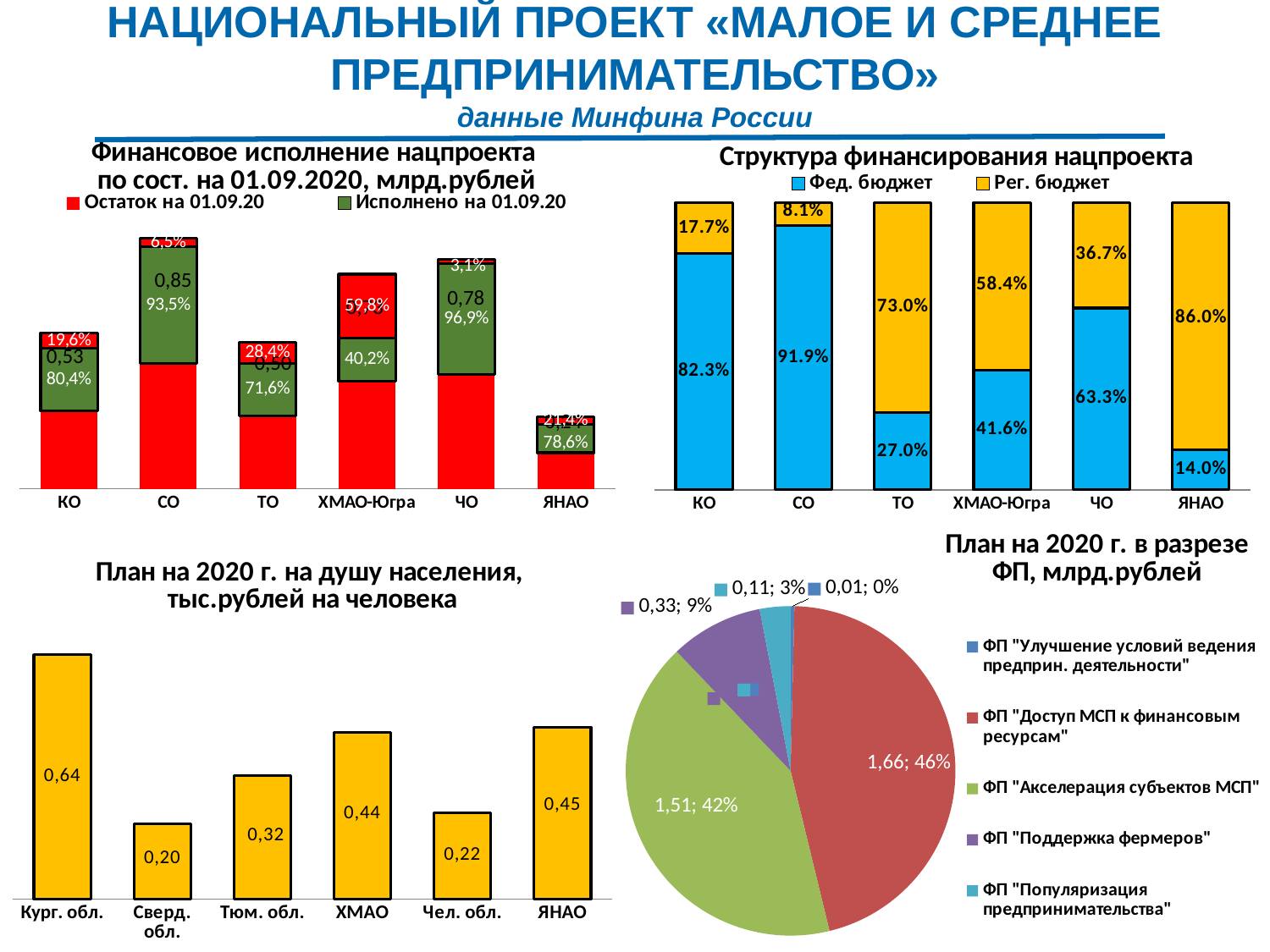
In the chart 'Структура финансирования нацпроекта', how many series does the legend list? 2 In the chart 'Структура финансирования нацпроекта', what is the share of Фед. бюджет for ТО? 27.0% In the chart 'План на 2020 г. на душу населения, тыс.рублей на человека', what is the value for Тюм. обл.? 0,32 In the chart 'Структура финансирования нацпроекта', which region has the highest share of Рег. бюджет? ЯНАО In the chart 'Структура финансирования нацпроекта', which region has the lowest share of Фед. бюджет? ЯНАО In the chart 'План на 2020 г. на душу населения, тыс.рублей на человека', how many regions are shown? 6 In the pie chart 'План на 2020 г. в разрезе ФП, млрд.рублей', what share does ФП "Акселерация субъектов МСП" have? 42% In the chart 'План на 2020 г. на душу населения, тыс.рублей на человека', which region has the highest value? Кург. обл. In the chart 'Структура финансирования нацпроекта', what is the difference between the Фед. бюджет share of СО and that of КО? 9.6% In the pie chart 'План на 2020 г. в разрезе ФП, млрд.рублей', what is the value for ФП "Поддержка фермеров"? 0,33 In the chart 'Финансовое исполнение нацпроекта по сост. на 01.09.2020, млрд.рублей', what percentage is shown for Исполнено на 01.09.20 for ЧО? 96,9% In the chart 'План на 2020 г. на душу населения, тыс.рублей на человека', which is larger: the value for ХМАО or the value for ЯНАО? ЯНАО